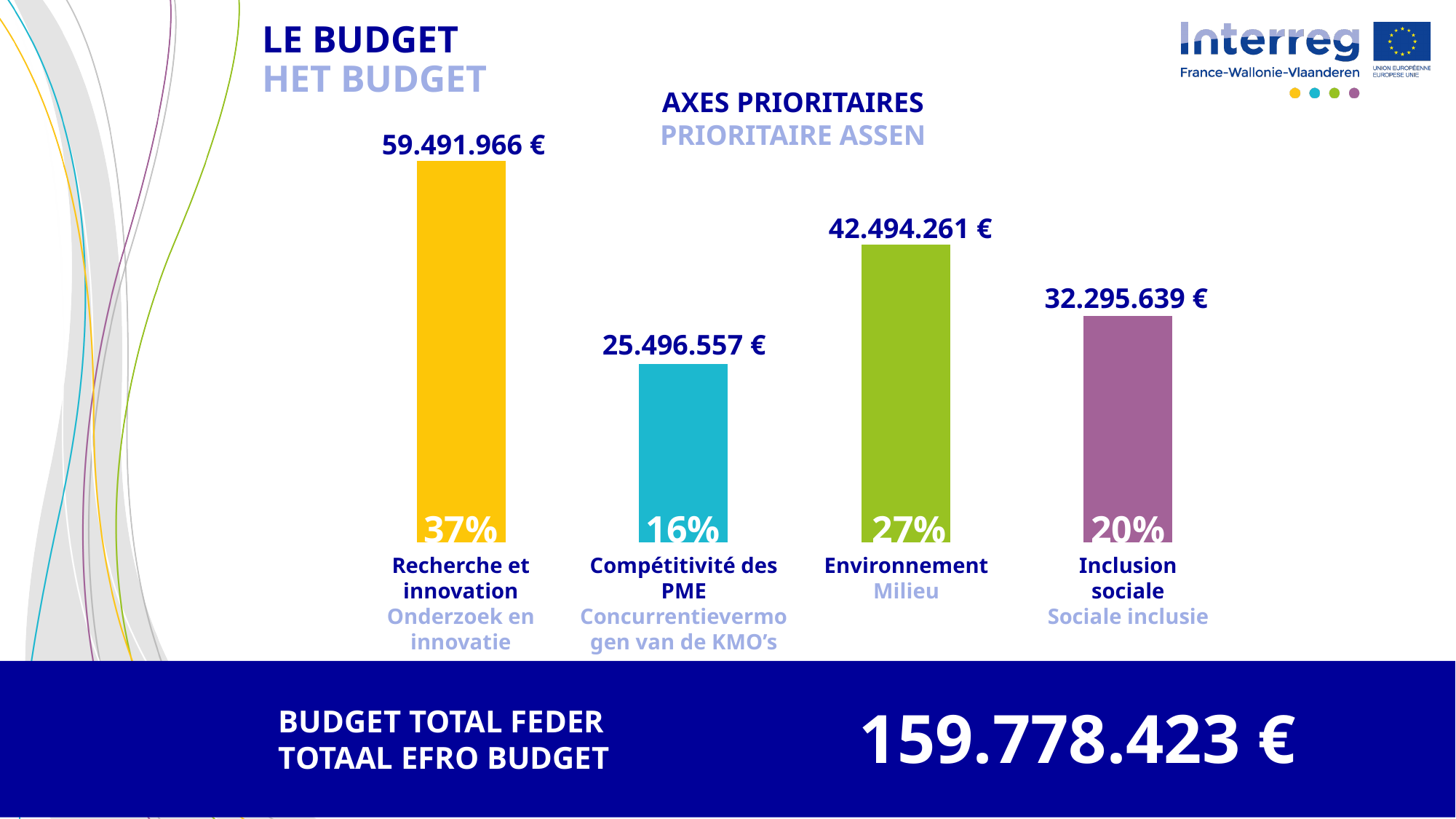
What is the difference between the budgets for Environnement and Inclusion sociale? 10.198.622 € What kind of chart is shown on the slide? Bar chart Which priority axis has the lowest budget? Compétitivité des PME What is the budget value shown for Environnement? 42.494.261 € Which priority axis has the highest budget? Recherche et innovation Which has a larger budget, Environnement or Inclusion sociale? Environnement What percentage is printed on the Inclusion sociale bar? 20% What is the budget value shown for Compétitivité des PME? 25.496.557 € What is the budget value shown for Recherche et innovation? 59.491.966 € What is the total FEDER budget shown on the slide? 159.778.423 € What is the difference between the budgets for Recherche et innovation and Compétitivité des PME? 33.995.409 € How many priority axes are shown in the chart? 4